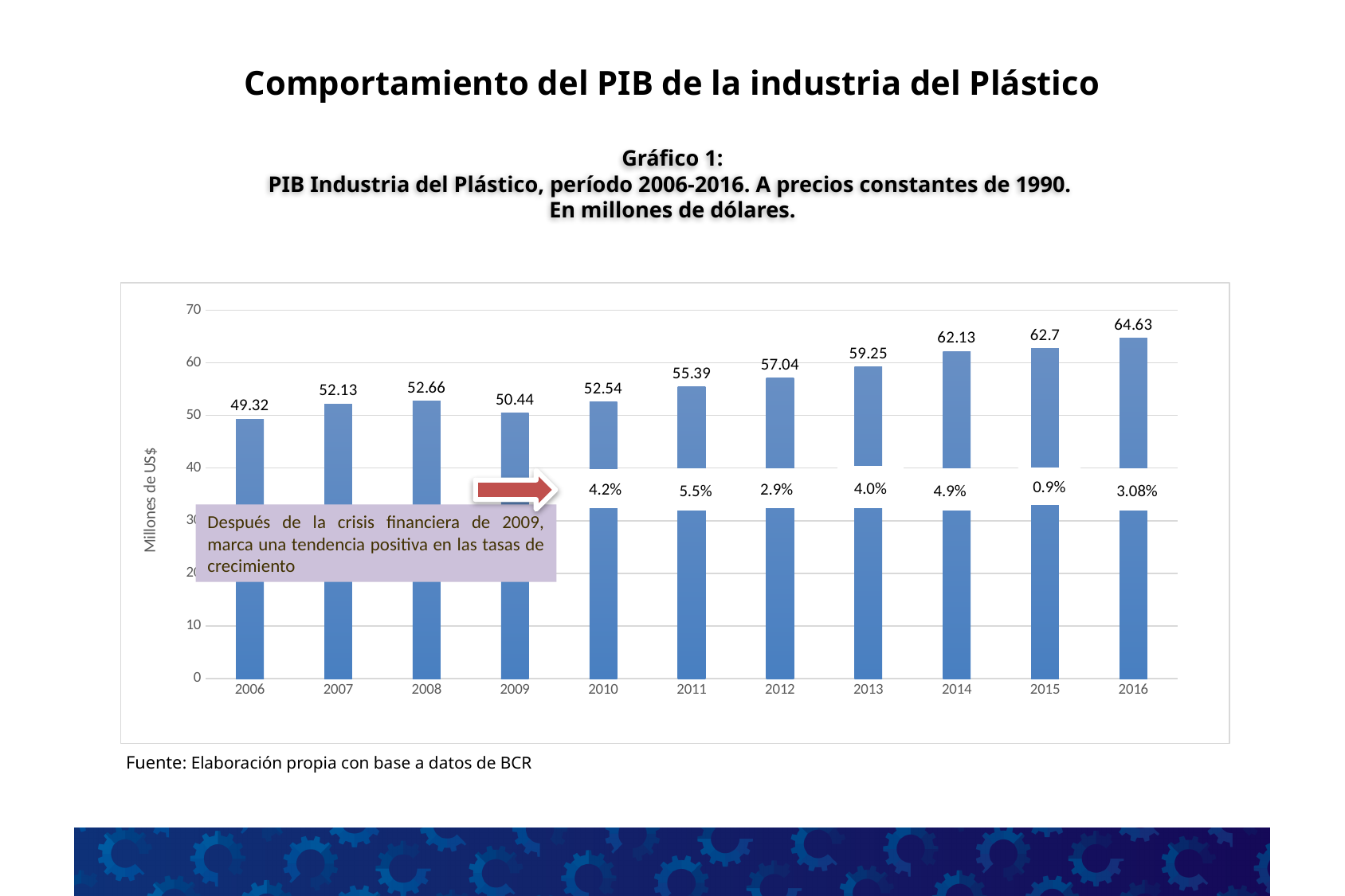
What is the value for 2006? 49.32 What is the difference between the values for 2008 and 2009? 2.22 What is the difference between the values for 2016 and 2006? 15.31 What is the value for 2013? 59.25 Which year has the lowest value? 2006 What is the label on the vertical axis? Millones de US$ What kind of chart is this? bar chart What is the value for 2016? 64.63 Which is larger, the value for 2009 or the value for 2011? 2011 Is the value for 2014 greater or less than 60? greater How many years are shown on the x axis? 11 Which year has the highest value? 2016